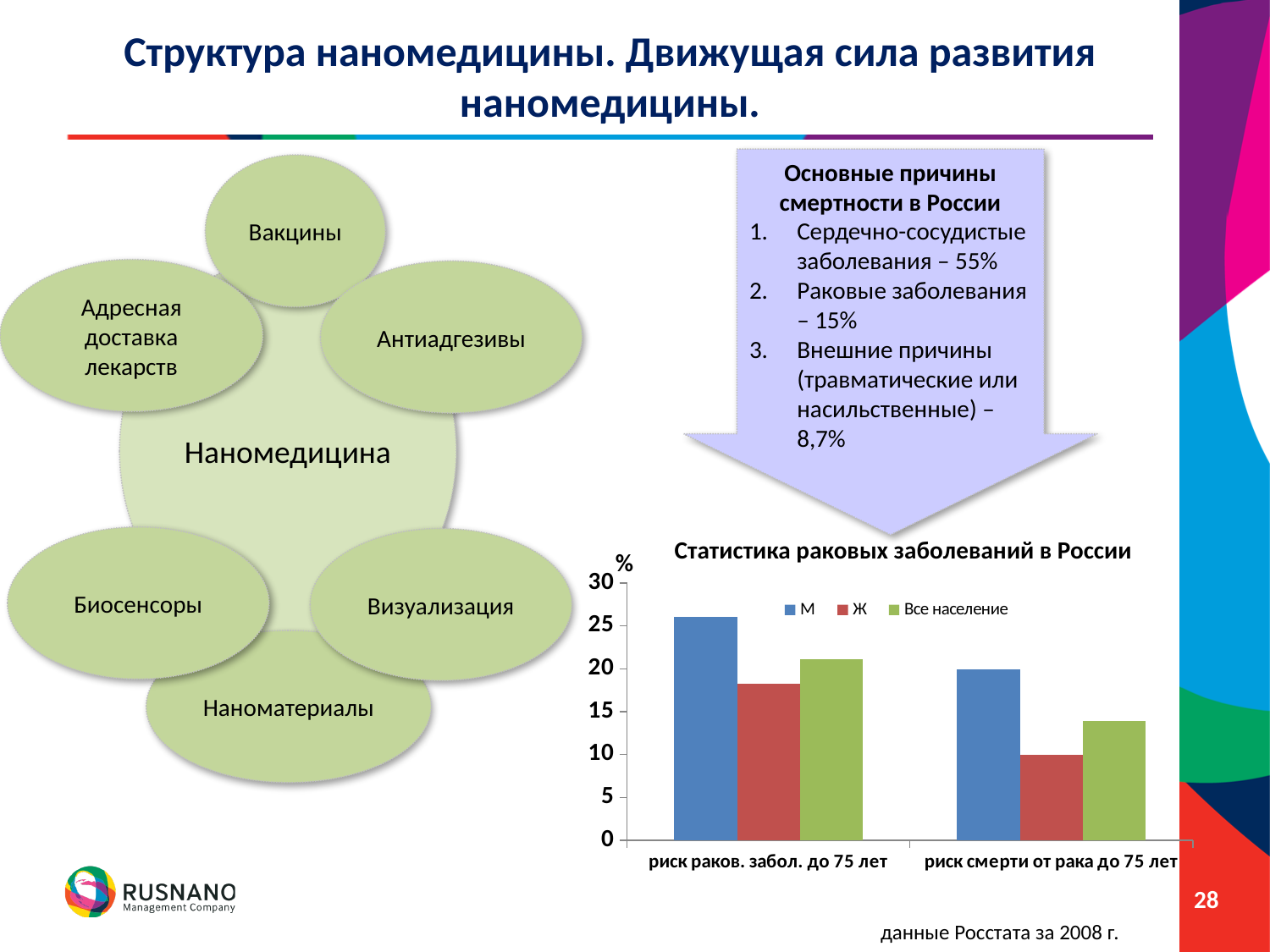
What kind of chart is "Статистика раковых заболеваний в России"? bar chart In the chart "Статистика раковых заболеваний в России", is the value for М in "риск раков. забол. до 75 лет" greater or less than 20? greater In the chart "Статистика раковых заболеваний в России", which series has the highest value for "риск раков. забол. до 75 лет"? М In the chart "Статистика раковых заболеваний в России", which series has the lowest value for "риск смерти от рака до 75 лет"? Ж In the chart "Статистика раковых заболеваний в России", which is larger for "риск смерти от рака до 75 лет": М or Ж? М In the chart "Статистика раковых заболеваний в России", is the value for Все население in "риск смерти от рака до 75 лет" greater or less than 10? greater How many categories are shown on the x axis of the chart "Статистика раковых заболеваний в России"? 2 What unit is shown on the y axis of the chart "Статистика раковых заболеваний в России"? % In the chart "Статистика раковых заболеваний в России", do the values for Ж rise or fall from "риск раков. забол. до 75 лет" to "риск смерти от рака до 75 лет"? fall How many series does the legend of the chart "Статистика раковых заболеваний в России" list? 3 In the chart "Статистика раковых заболеваний в России", is the value for Ж in "риск раков. забол. до 75 лет" greater or less than 20? less